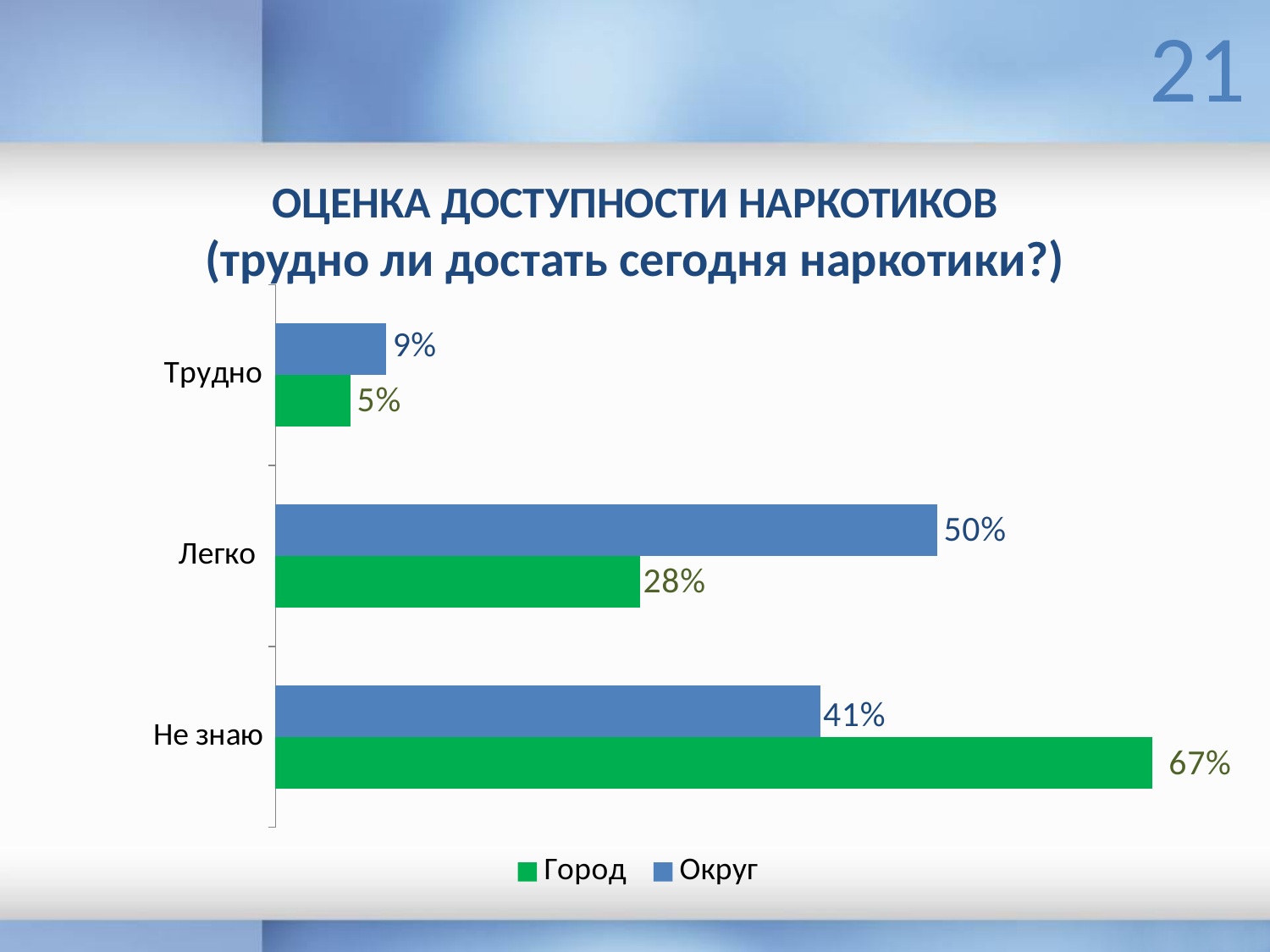
What is the value for Округ in the Легко category? 50% Which category has the highest value for the Город series? Не знаю What kind of chart is shown on the slide? Bar chart Which category has the lowest value for the Округ series? Трудно How many series does the legend list? 2 What is the value for Город in the Трудно category? 5% What is the difference between the Округ and Город values in the Легко category? 22% What is the value for Город in the Не знаю category? 67% What is the value for Округ in the Трудно category? 9% Which is larger in the Не знаю category, Город or Округ? Город How many categories are shown on the chart? 3 Which colour represents the Округ series? Blue